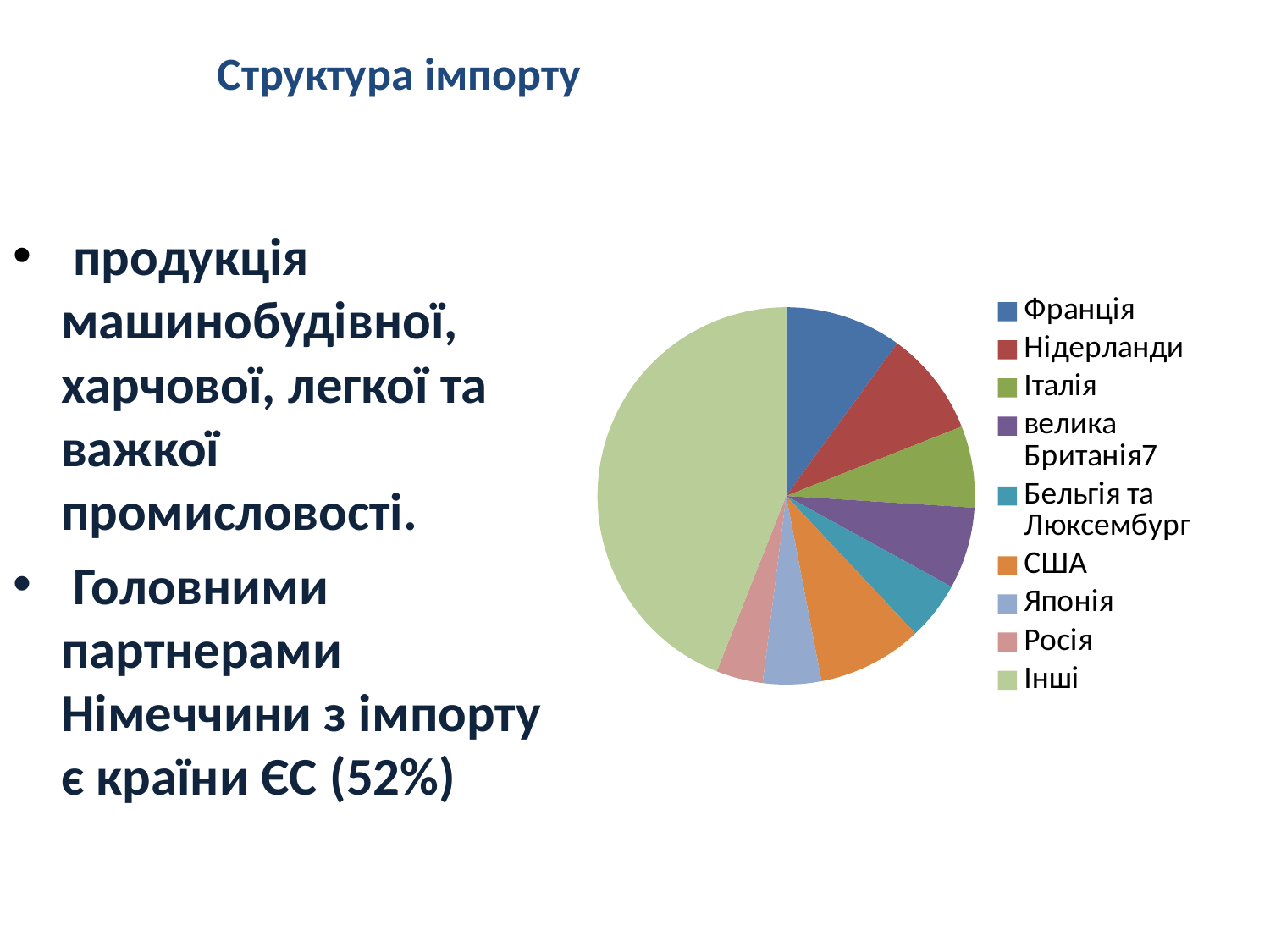
Which slice is larger in the pie chart, Франція or Росія? Франція Which slice is larger in the pie chart, США or Росія? США Which slice is larger in the pie chart, Інші or Франція? Інші What is the title of the slide containing the pie chart? Структура імпорту What colour is the Інші slice in the pie chart? light green Which legend entry is listed first in the pie chart's legend? Франція How many categories (slices) does the pie chart's legend list? 9 Which category has the largest slice in the pie chart? Інші What kind of chart is shown on the slide? pie chart